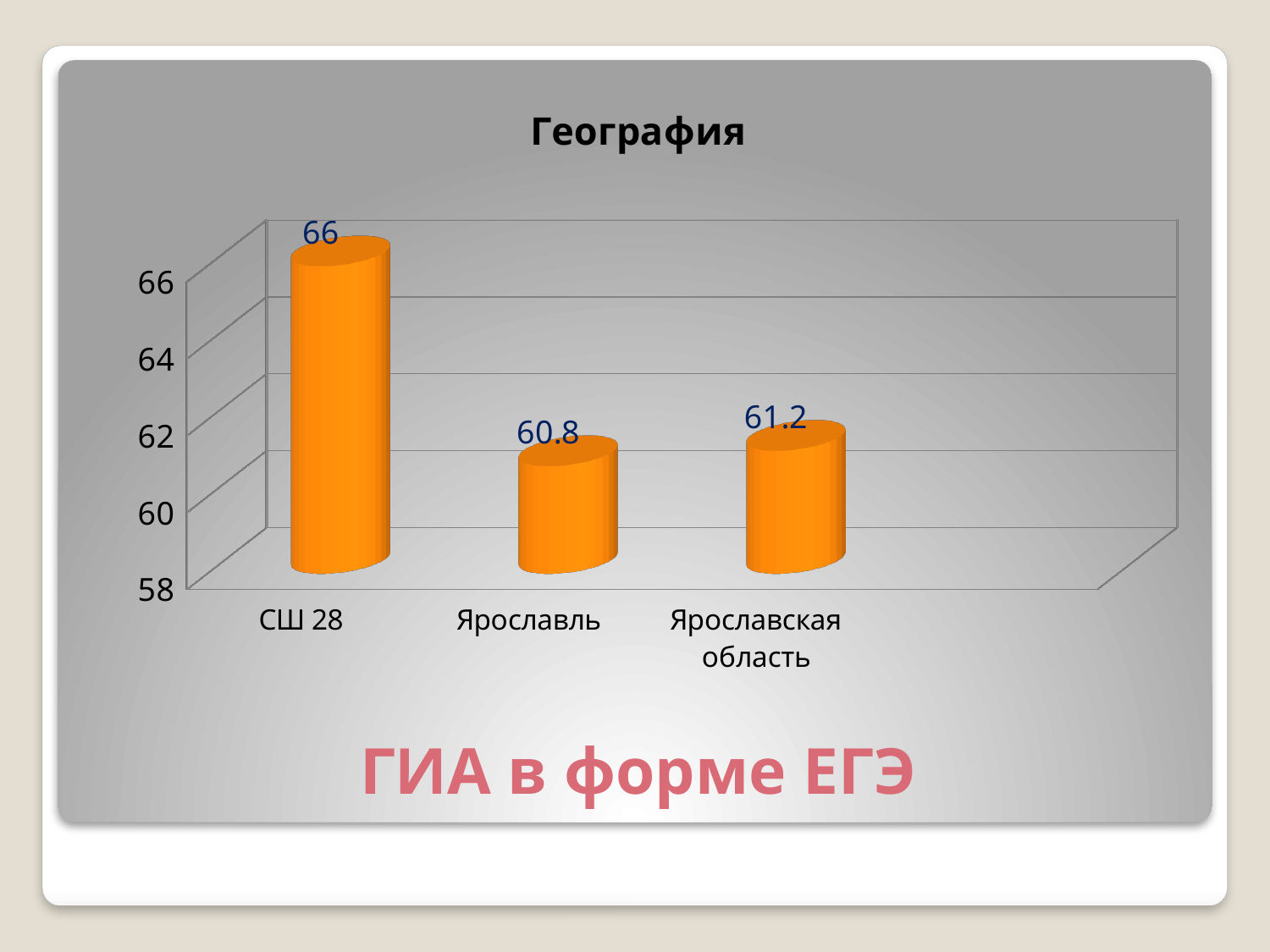
What is the title of the chart on the slide? География What is the difference between the values for СШ 28 and Ярославль? 5.2 What is the value for Ярославская область in the География chart? 61.2 What is the value for СШ 28 in the География chart? 66 What is the difference between the values for Ярославская область and Ярославль? 0.4 Which category has the highest value in the География chart? СШ 28 What is the value for Ярославль in the География chart? 60.8 What kind of chart is shown on the slide? bar chart Which is larger: the value for СШ 28 or the value for Ярославская область? СШ 28 Is the value for Ярославль greater or less than 62? less How many categories are shown in the География chart? 3 Which category has the lowest value in the География chart? Ярославль